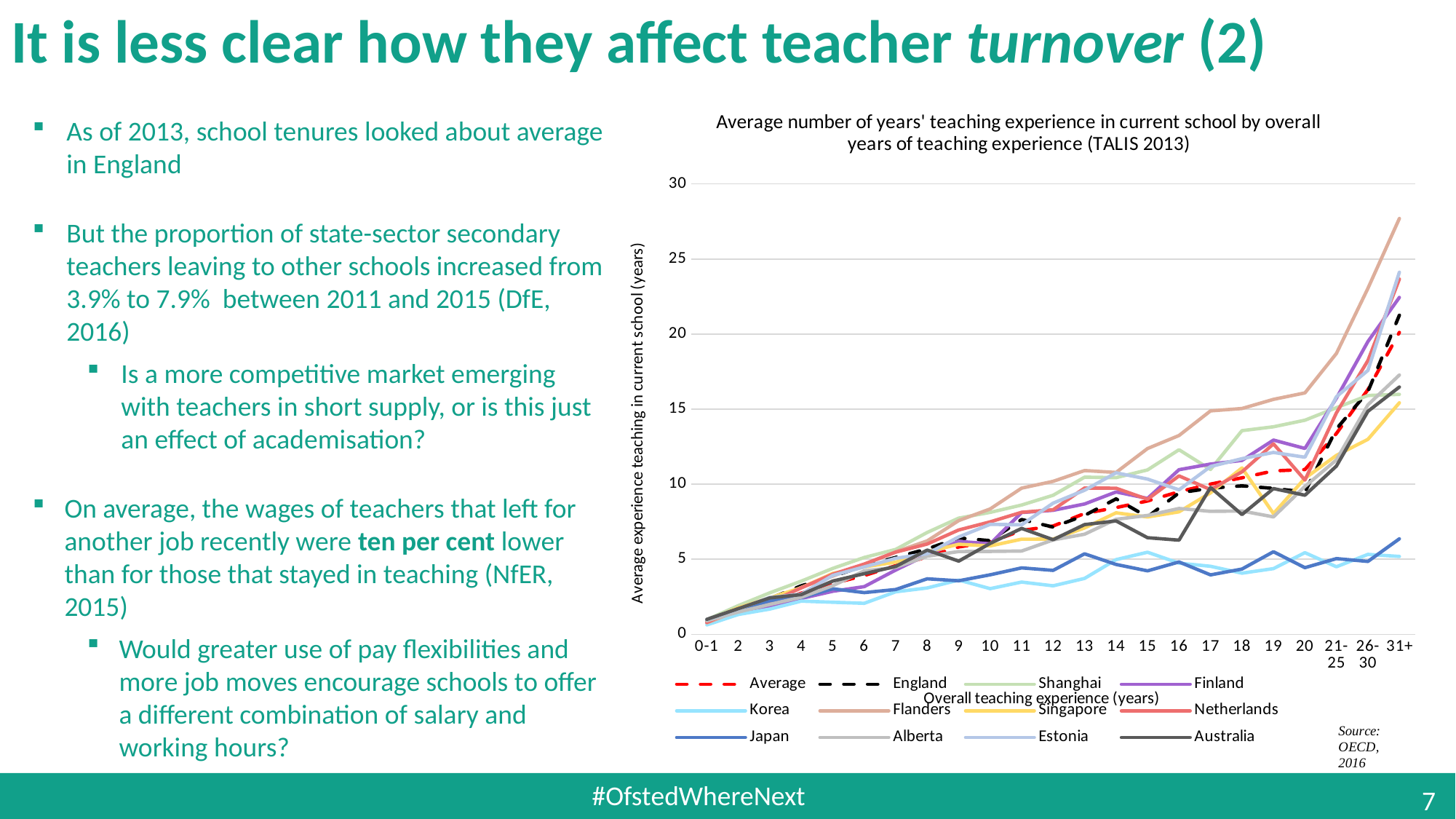
What kind of chart is shown on the slide? line chart How many series does the legend of the chart list? 12 Is the value for Flanders at 31+ greater or less than 25? greater What is the label of the y axis of the chart? Average experience teaching in current school (years) Which series has the lowest value at the 31+ category? Korea Is the value for Flanders at 20 years greater or less than 15? greater Is the value for Korea at 31+ greater or less than 10? less How many categories are shown along the x axis of the chart? 23 Does the Flanders line rise or fall as overall teaching experience increases? rises At the 31+ category, which is larger: Japan or Korea? Japan Which series has the highest value at the 31+ category? Flanders